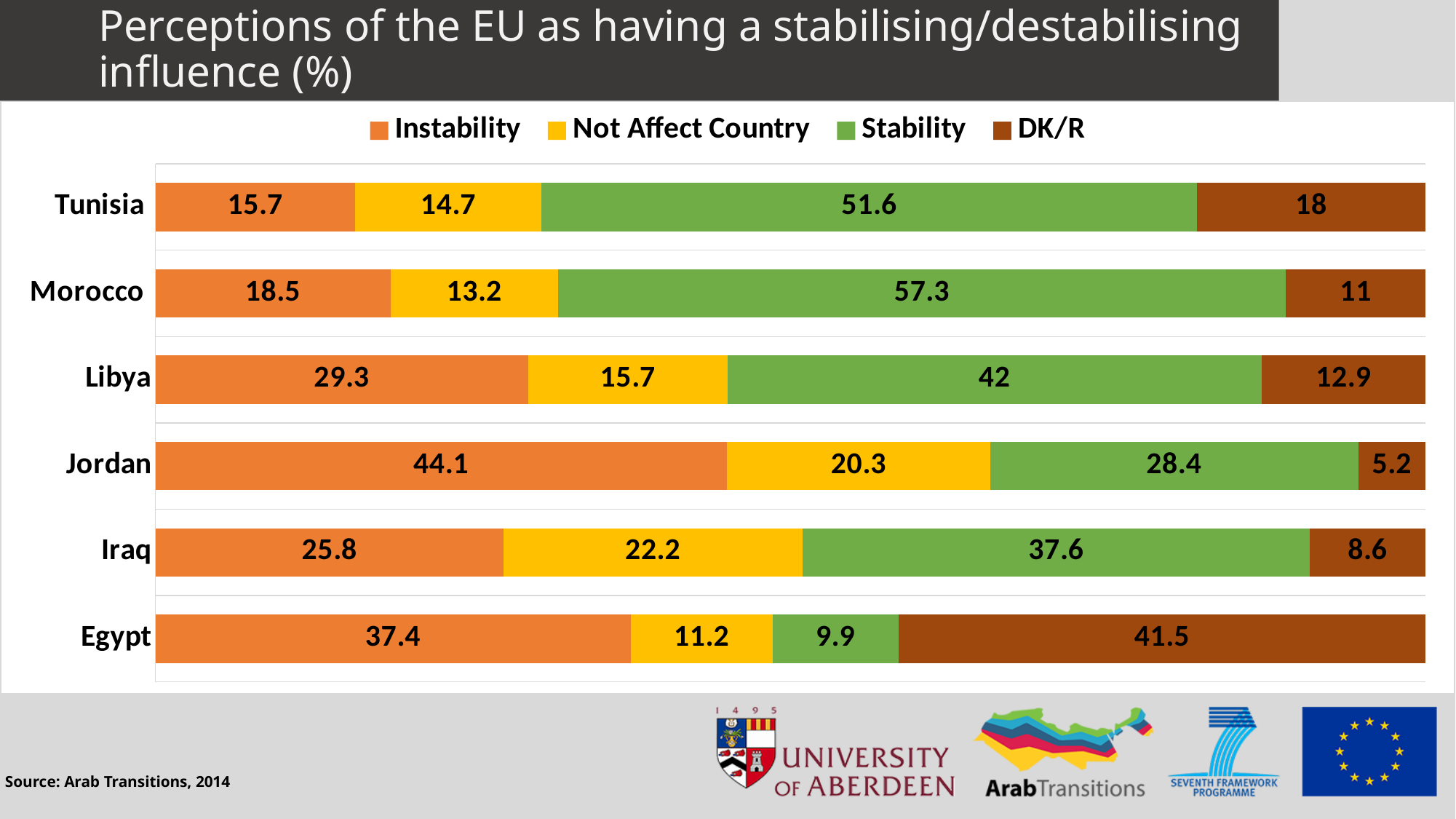
How many countries are shown in the chart? 6 Which country has the lowest Stability value? Egypt What is the total of the stacked bar for Iraq? 94.2 What is the DK/R value for Egypt? 41.5 How many series does the legend list? 4 Which country has the lowest DK/R value? Jordan Which is larger, the Instability value for Libya or for Iraq? Libya What is the Not Affect Country value for Iraq? 22.2 What is the difference between the Stability values for Morocco and Tunisia? 5.7 What kind of chart is shown on the slide? Stacked bar chart Which country has the highest Instability value? Jordan What is the Stability value for Morocco? 57.3